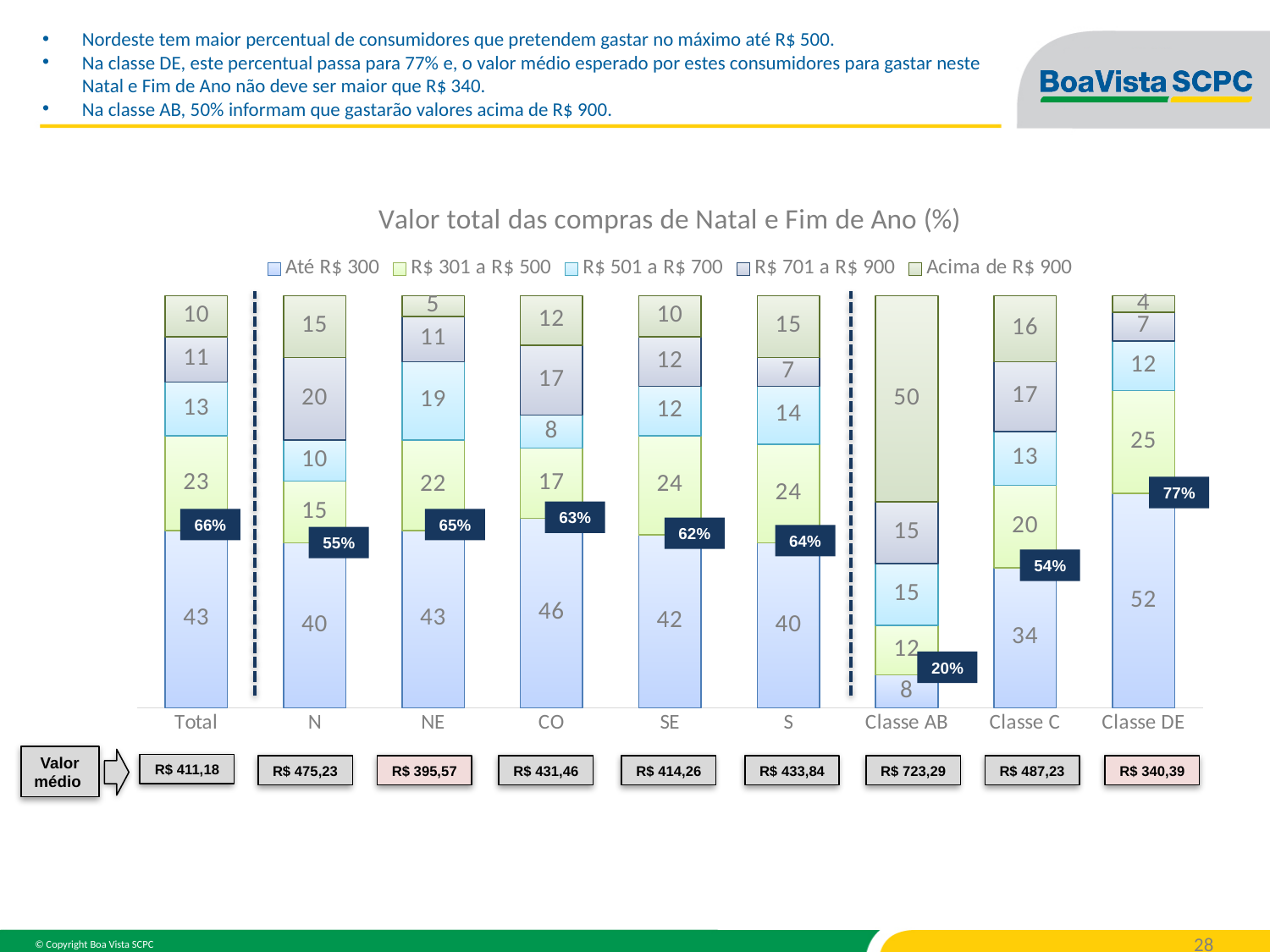
What is the value of the 'R$ 701 a R$ 900' segment for N? 20 How many categories are shown along the x axis? 9 What is the value of the 'Acima de R$ 900' segment for Classe AB? 50 Which category has the highest 'Até R$ 300' value? Classe DE What is the title of the chart? Valor total das compras de Natal e Fim de Ano (%) Which category has the lowest 'Até R$ 300' value? Classe AB What is the difference between the 'R$ 301 a R$ 500' values for SE and N? 9 What is the value of the 'Até R$ 300' segment for Classe DE? 52 Which is larger, the 'R$ 501 a R$ 700' value for NE or for CO? NE What is the 'Valor médio' shown for Classe AB? R$ 723,29 What kind of chart is shown on the slide? Stacked bar chart How many series does the legend list? 5